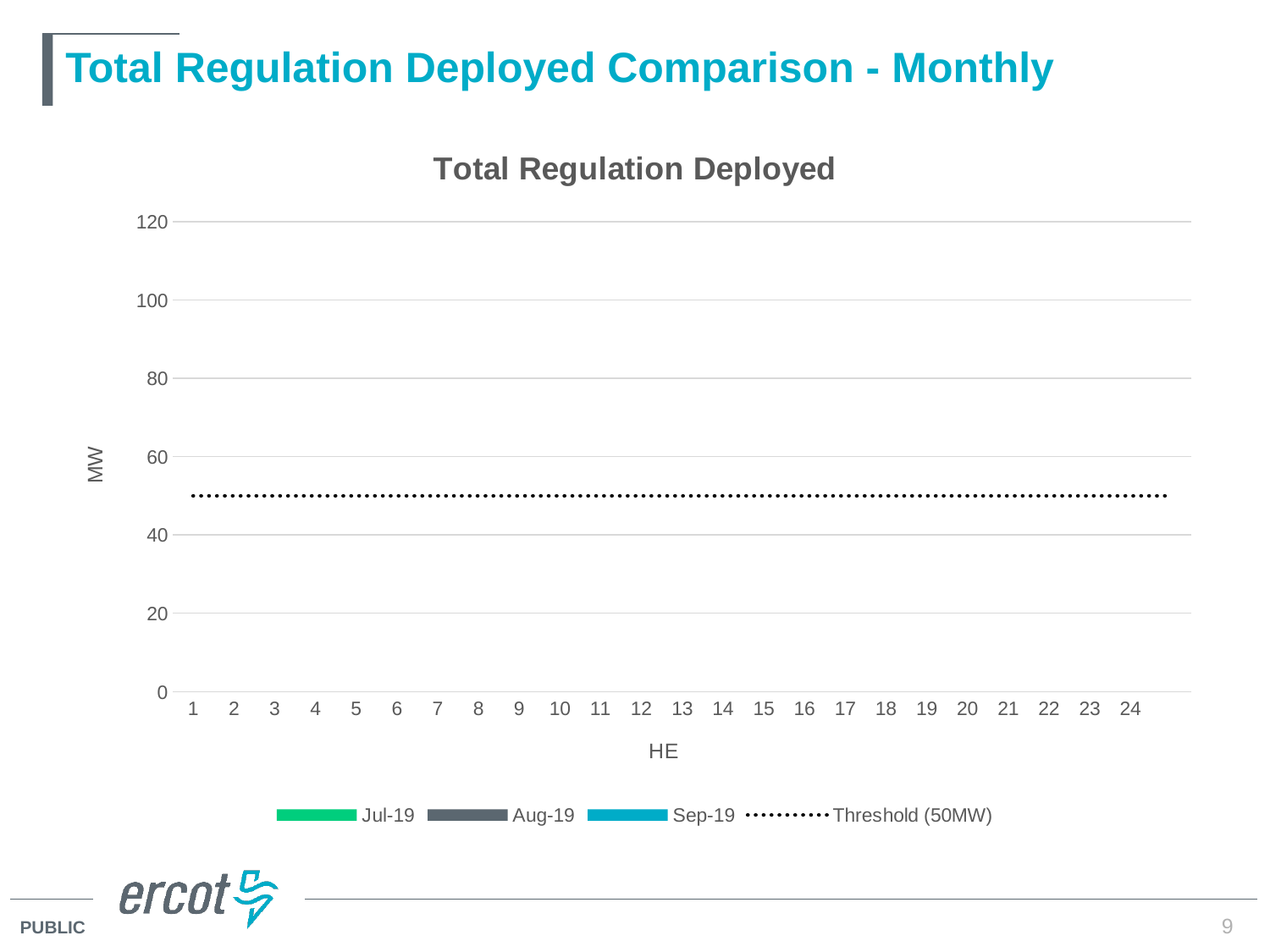
What is the title of the chart? Total Regulation Deployed How many series does the chart legend list? 4 Is the Threshold line plotted at a value greater or less than 40? greater How many hour-ending (HE) categories are shown on the x axis? 24 What is the highest value shown on the y axis? 120 Does the Threshold line rise, fall, or stay flat across the x axis? stay flat Is the Threshold line plotted at a value greater or less than 60? less What unit is shown on the y axis label? MW What value does the Threshold line represent, according to the legend? 50MW